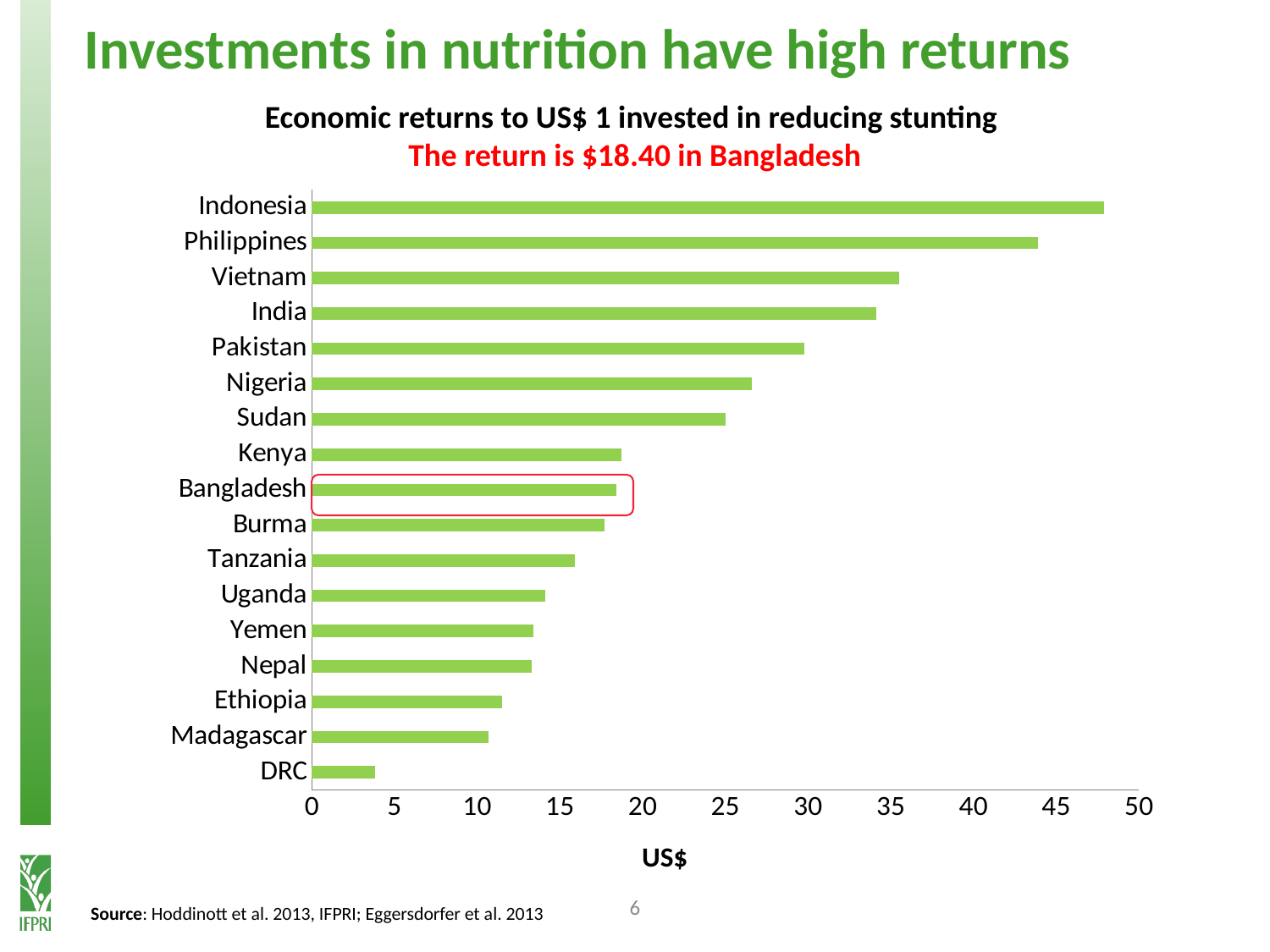
Is the value for DRC greater or less than 5? less Is the value for India greater or less than 35? less What is the economic return to US$ 1 invested in reducing stunting in Bangladesh? $18.40 How many countries are shown in the chart? 17 Which has a higher economic return, the Philippines or Vietnam? Philippines Is the value for Uganda greater or less than 15? less What kind of chart is shown on the slide? bar chart Do the bar values increase or decrease going from the top of the chart to the bottom? decrease Which country has the highest economic return per US$ 1 invested? Indonesia What is the label on the horizontal axis of the chart? US$ Which country has the lowest economic return per US$ 1 invested? DRC